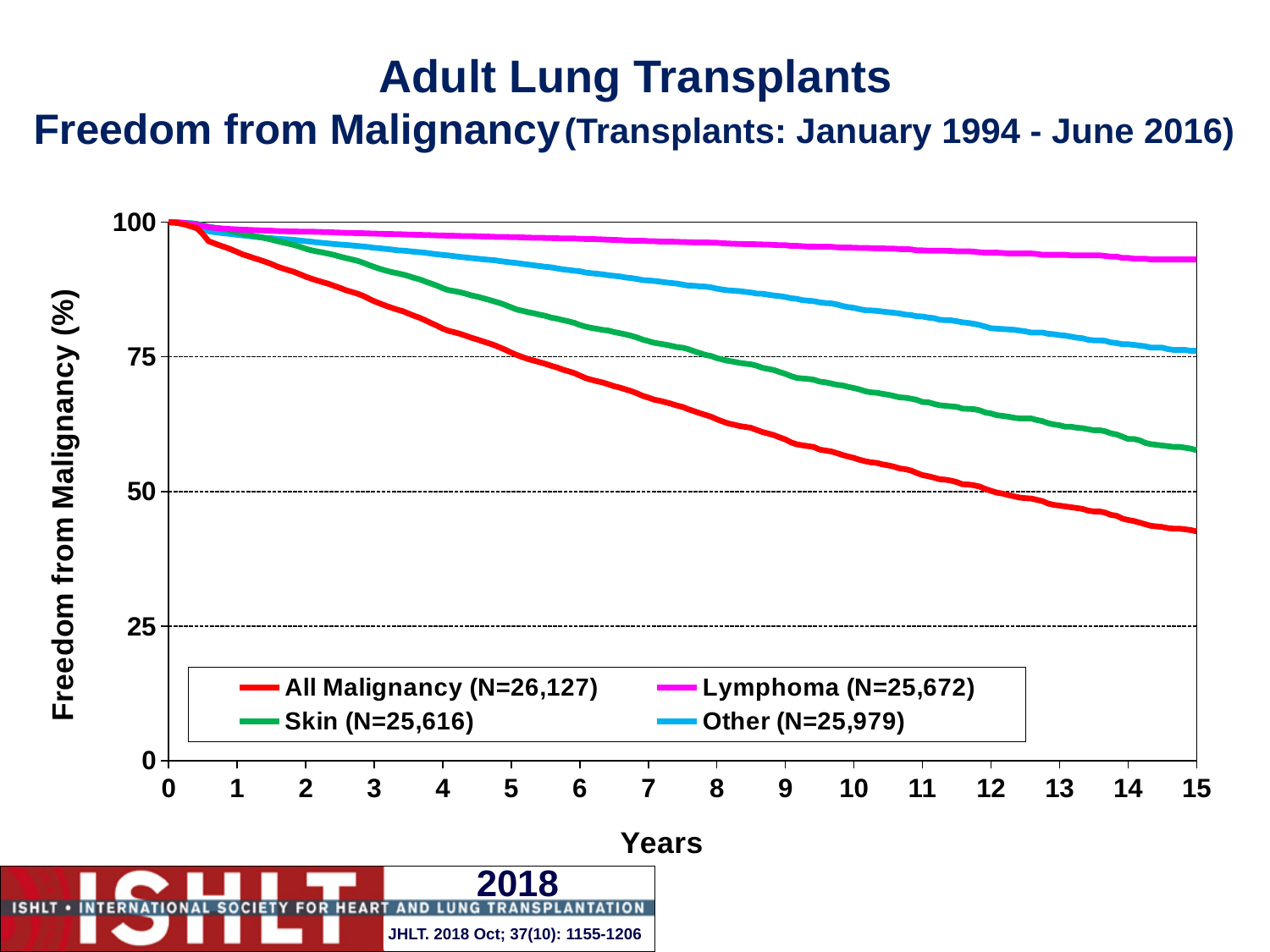
Do the values for All Malignancy rise or fall as years increase? Fall Is the value for Lymphoma at 15 years greater or less than 75? greater Is the value for All Malignancy at 15 years greater or less than 50? less Is the value for Skin at 15 years greater or less than 50? greater How many series does the legend list? 4 At 10 years, which is larger: the value for Skin or the value for Other? Other Which series has the highest freedom from malignancy at 15 years? Lymphoma Which series has the lowest freedom from malignancy at 15 years? All Malignancy What kind of chart is shown on the slide? Line chart What is the freedom from malignancy value for all series at year 0? 100 What is the N shown in the legend for the Skin series? N=25,616